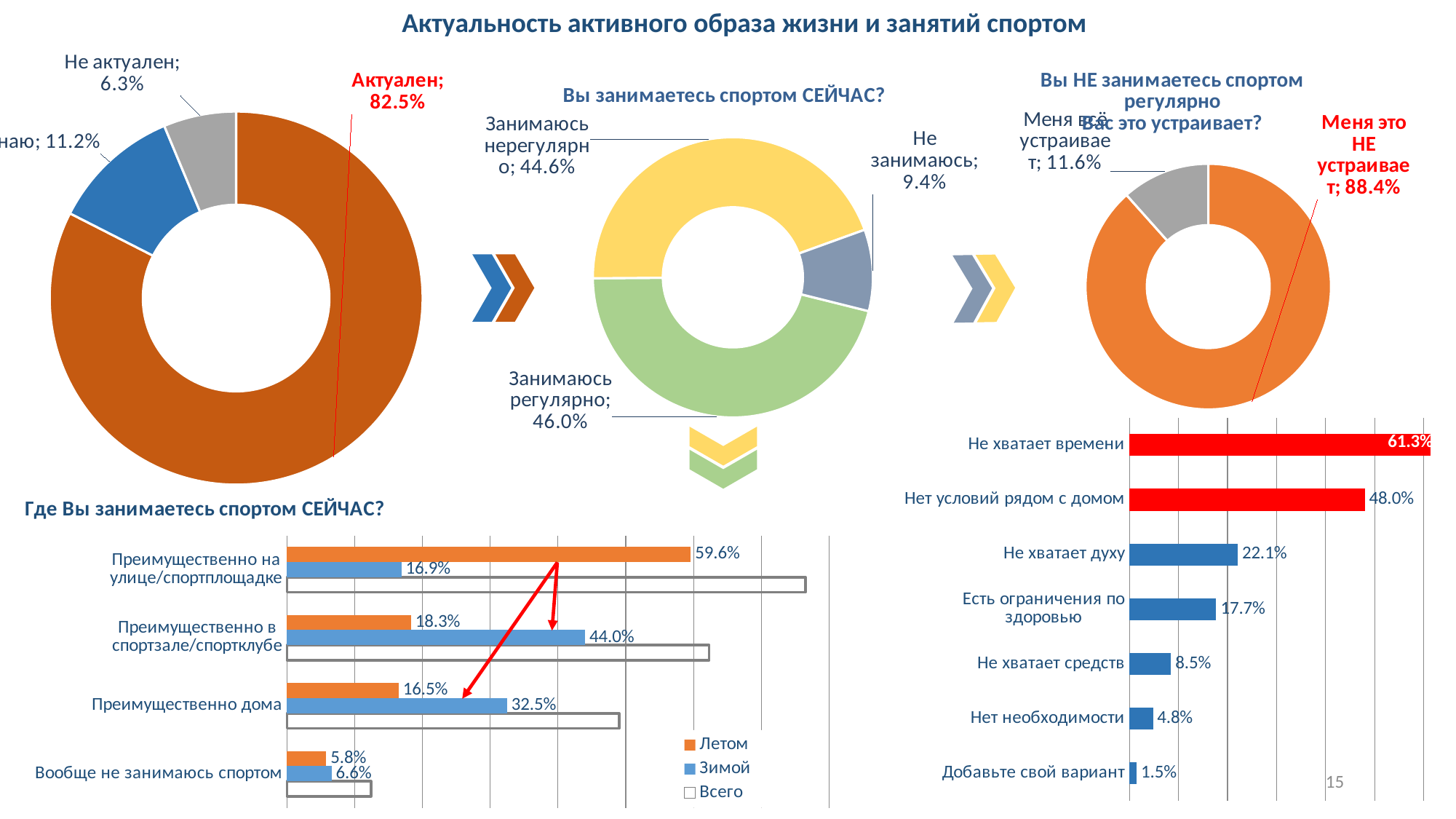
In the top-left donut chart, what share is 'Не актуален'? 6.3% In the donut chart 'Вы занимаетесь спортом СЕЙЧАС?', what share is 'Занимаюсь регулярно'? 46.0% In the bottom-right bar chart, which category has the lowest value? Добавьте свой вариант In the bottom-right bar chart, what is the value for 'Не хватает времени'? 61.3% In the top-left donut chart, what share is 'Актуален'? 82.5% In the bottom-right bar chart, what is the difference between 'Не хватает времени' and 'Нет условий рядом с домом'? 13.3% In the bar chart 'Где Вы занимаетесь спортом СЕЙЧАС?', how many series does the legend list? 3 In the donut chart 'Вы занимаетесь спортом СЕЙЧАС?', which category has the largest share? Занимаюсь регулярно In the bar chart 'Где Вы занимаетесь спортом СЕЙЧАС?', what is the value for 'Зимой' for 'Преимущественно в спортзале/спортклубе'? 44.0% In the bar chart 'Где Вы занимаетесь спортом СЕЙЧАС?', which is larger for 'Преимущественно дома': 'Летом' or 'Зимой'? Зимой